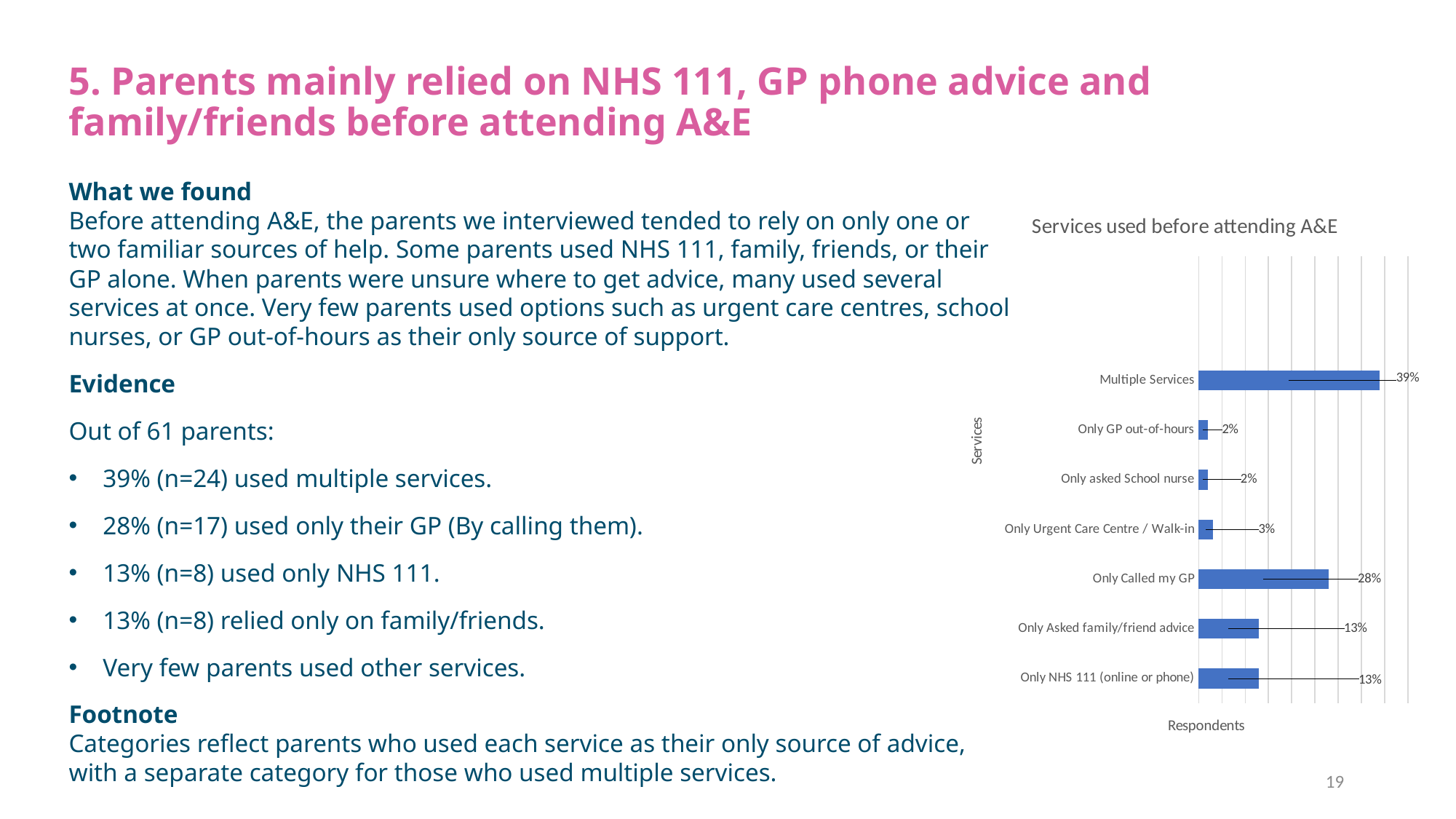
What is the value for Only Called my GP? 28% What is the value for Only NHS 111 (online or phone)? 13% What is the value for Multiple Services? 39% Which is larger, the value for Only Called my GP or the value for Only Asked family/friend advice? Only Called my GP What is the value for Only Urgent Care Centre / Walk-in? 3% What is the difference between the values for Multiple Services and Only Called my GP? 11% How many categories are plotted in the chart? 7 What is the label on the horizontal axis of the chart? Respondents What is the title of the chart? Services used before attending A&E What is the value for Only GP out-of-hours? 2% Which category has the highest value? Multiple Services What kind of chart is shown on the slide? Bar chart